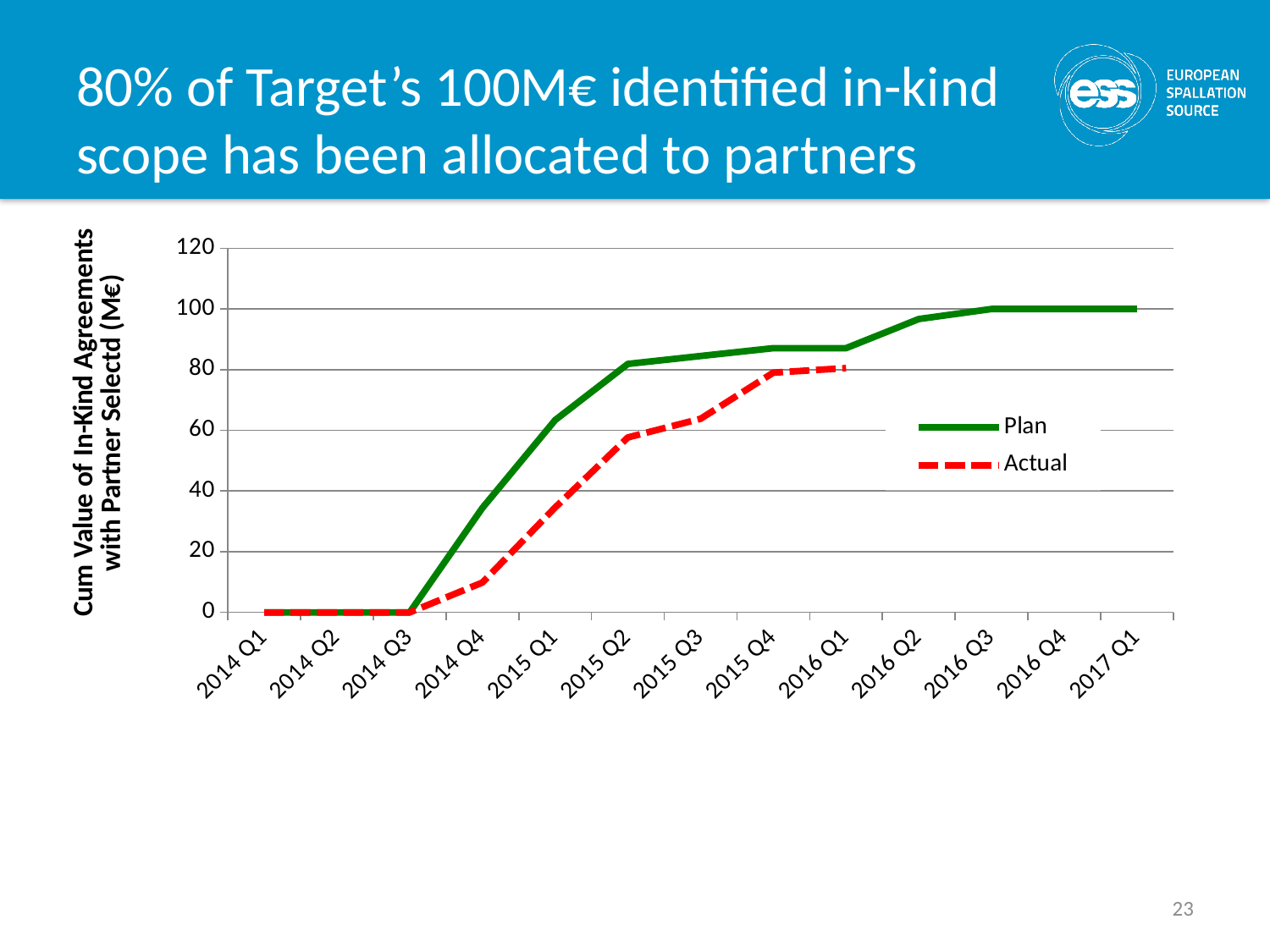
What kind of chart is shown on the slide? line chart What is the Plan value at 2014 Q2? 0 Is the Actual value at 2015 Q1 greater or less than 40? less How many series does the legend list? 2 How many quarters are shown along the x axis? 13 Which series is drawn as a red dashed line? Actual Is the Plan value at 2014 Q4 greater or less than 40? less Is the Plan value at 2015 Q4 greater or less than 80? greater Does the Plan series rise or fall from 2014 Q3 to 2016 Q3? rise At 2015 Q2, which series has the higher value, Plan or Actual? Plan What is the Plan value at 2017 Q1? 100